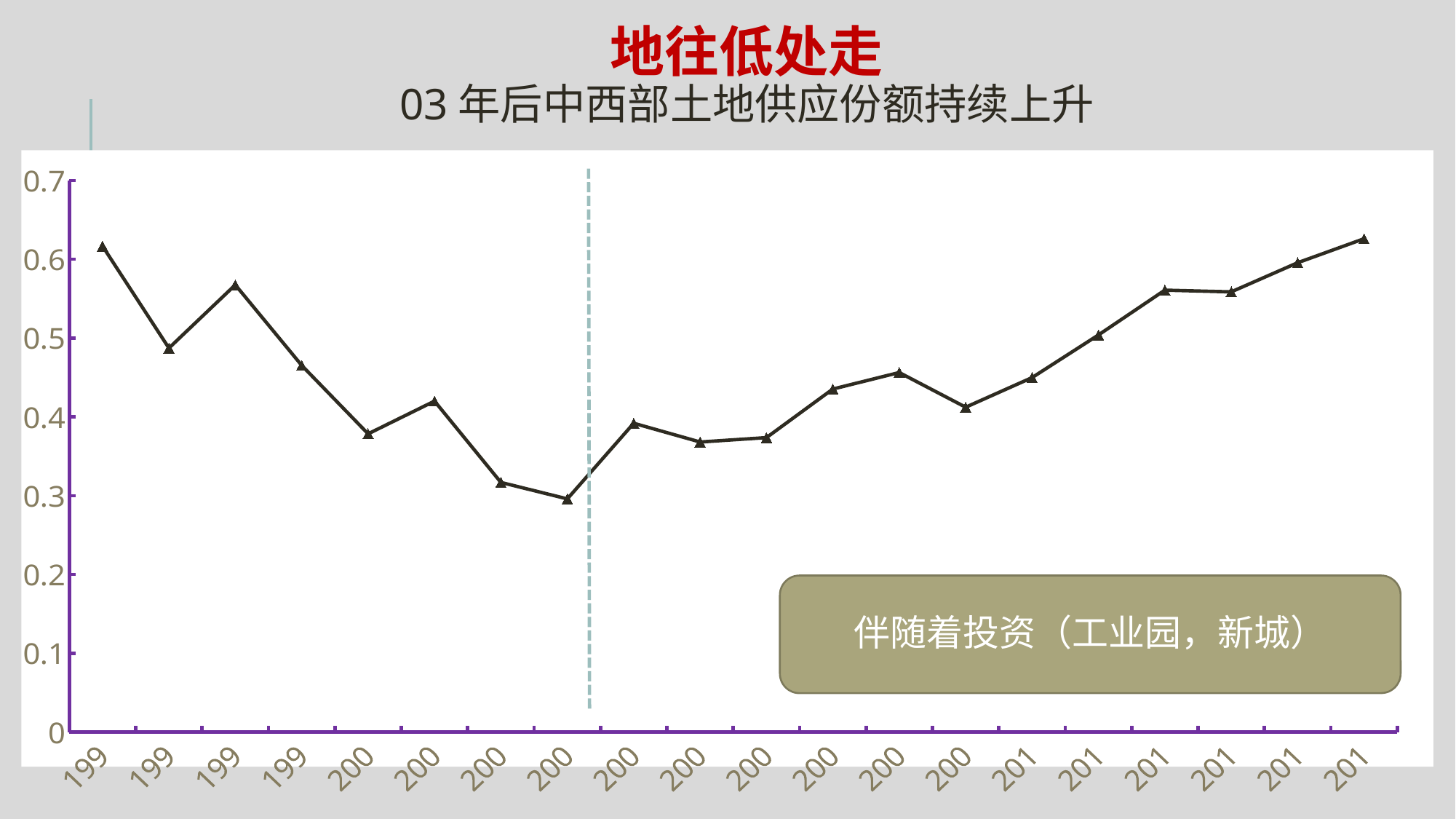
Is the value of the last data point on the right greater or less than 0.5? greater Is the lowest point on the line greater or less than 0.4? less What is the highest tick value shown on the y axis? 0.7 Is the value of the first data point on the left greater or less than 0.5? greater Do the values generally rise or fall from the first point up to the dashed vertical line? fall What kind of chart is shown on the slide? line chart How many lines (series) are plotted on the chart? 1 How many data points are plotted on the line? 20 Which is larger: the value of the second data point or the value of the third data point? the third data point Do the values generally rise or fall from the dashed vertical line to the right end of the chart? rise What text is written in the box inside the chart area? 伴随着投资（工业园，新城）